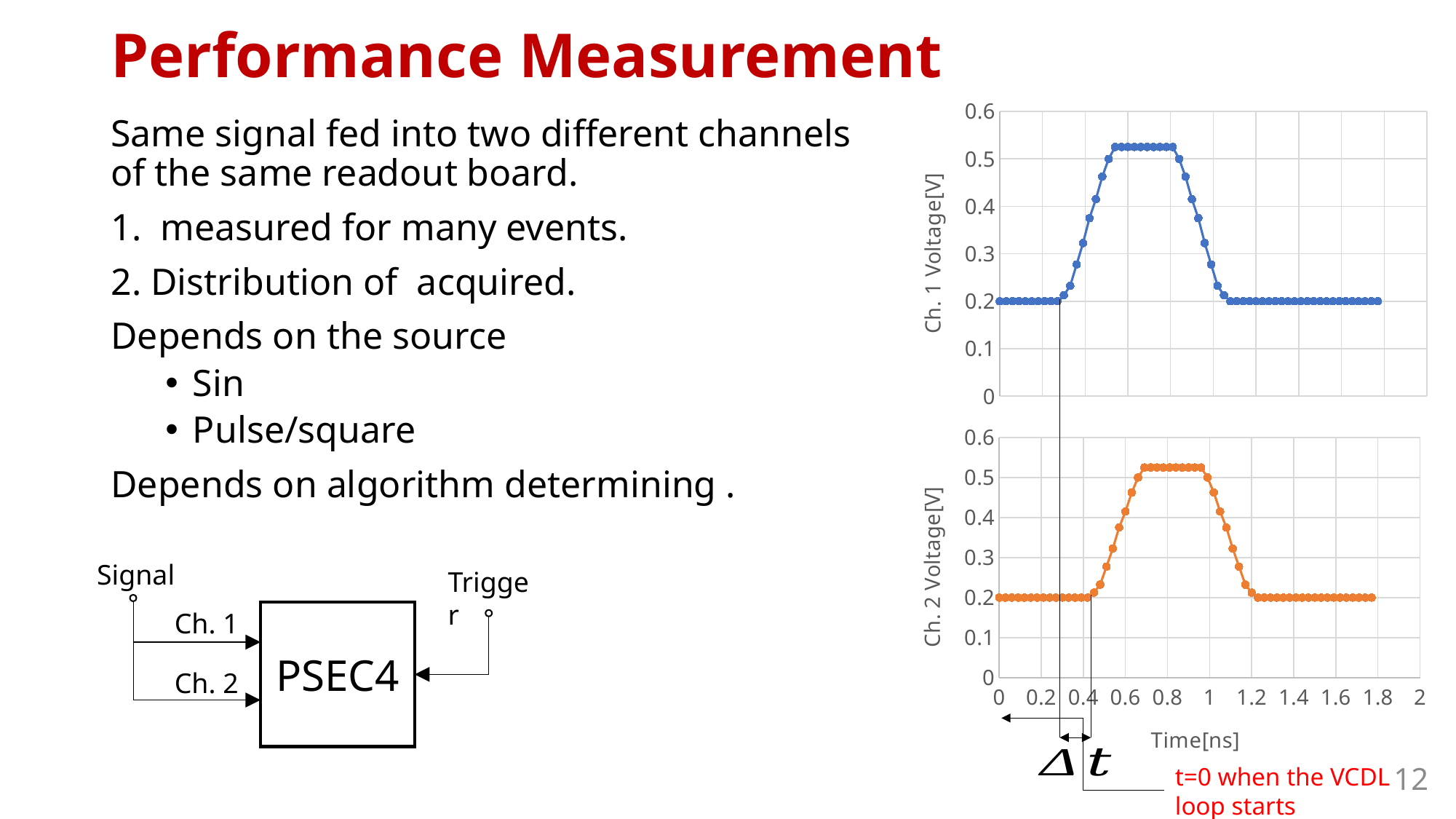
In the top chart (Ch. 1 Voltage[V]), is the peak voltage greater or less than 0.5? greater In the bottom chart (Ch. 2 Voltage[V]), is the voltage at 1.6 ns greater or less than 0.3? less What kind of chart is the top chart labelled Ch. 1 Voltage[V]? scatter chart At 1.0 ns, which is larger: the voltage in the top chart (Ch. 1) or the voltage in the bottom chart (Ch. 2)? Ch. 2 At 0.6 ns, which is larger: the voltage in the top chart (Ch. 1) or the voltage in the bottom chart (Ch. 2)? Ch. 1 In the top chart (Ch. 1 Voltage[V]), what is the voltage at time 0 ns? 0.2 In the bottom chart (Ch. 2 Voltage[V]), does the voltage rise or fall between 0.4 ns and 0.7 ns? rise What colour are the data markers in the top chart (Ch. 1 Voltage[V])? blue What is the y-axis label of the bottom chart? Ch. 2 Voltage[V] In the bottom chart (Ch. 2 Voltage[V]), is the voltage at 0.8 ns greater or less than 0.4? greater In the top chart (Ch. 1 Voltage[V]), does the voltage rise or fall between 0.9 ns and 1.1 ns? fall In the bottom chart (Ch. 2 Voltage[V]), what is the voltage at time 1.8 ns? 0.2